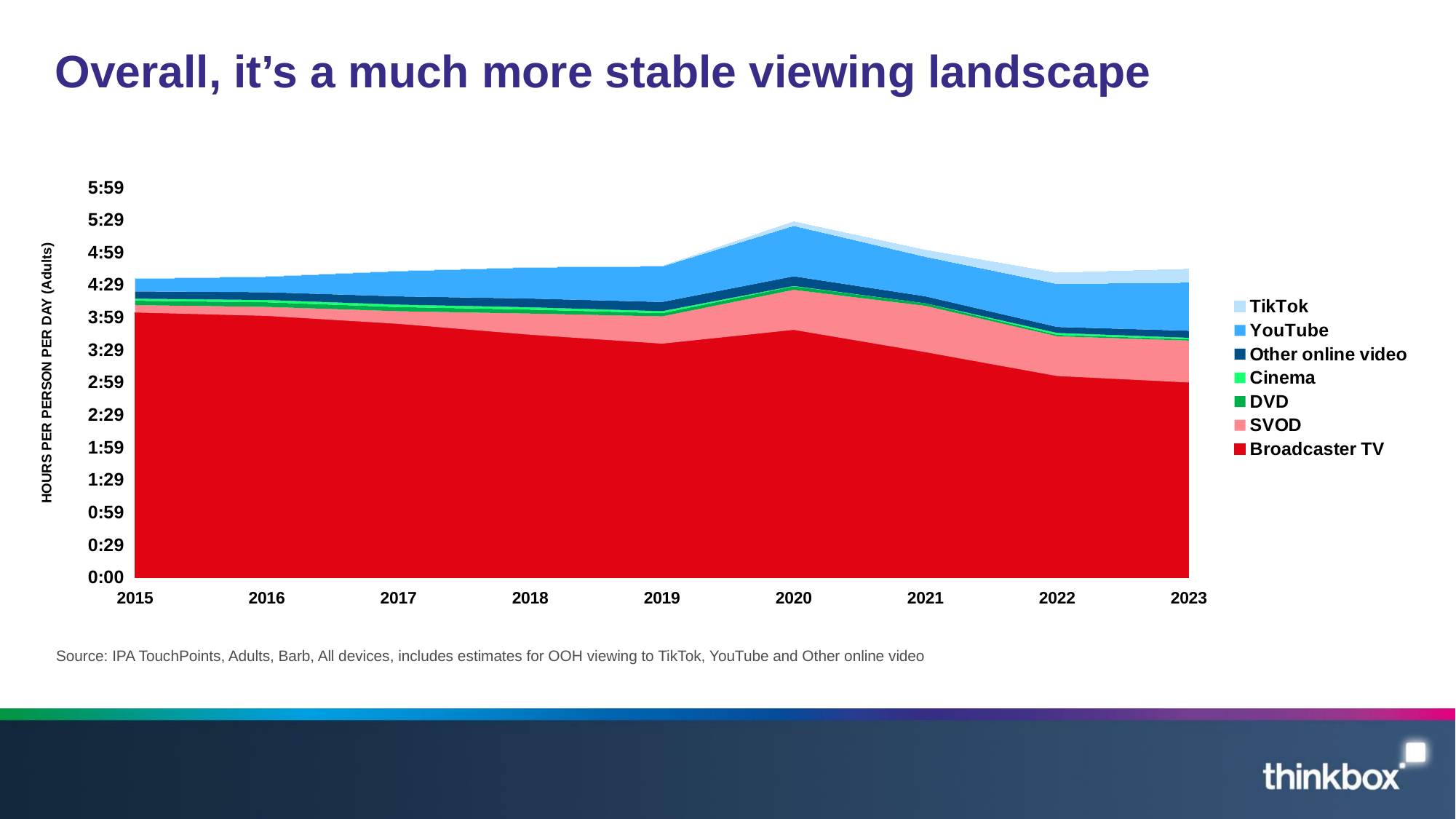
What is the label on the y axis? HOURS PER PERSON PER DAY (Adults) What is the title of the slide? Overall, it's a much more stable viewing landscape Is the value for Broadcaster TV in 2020 greater or less than 3:29? greater What kind of chart is shown on the slide? Stacked area chart Is the total viewing in 2020 greater or less than 4:59? greater Does Broadcaster TV viewing rise or fall from 2020 to 2023? fall Which year has the highest total viewing hours per person per day? 2020 Which series accounts for the largest share of viewing in every year? Broadcaster TV Is the value for Broadcaster TV in 2022 greater or less than 3:29? less How many series does the legend list? 7 How many years are plotted along the x axis? 9